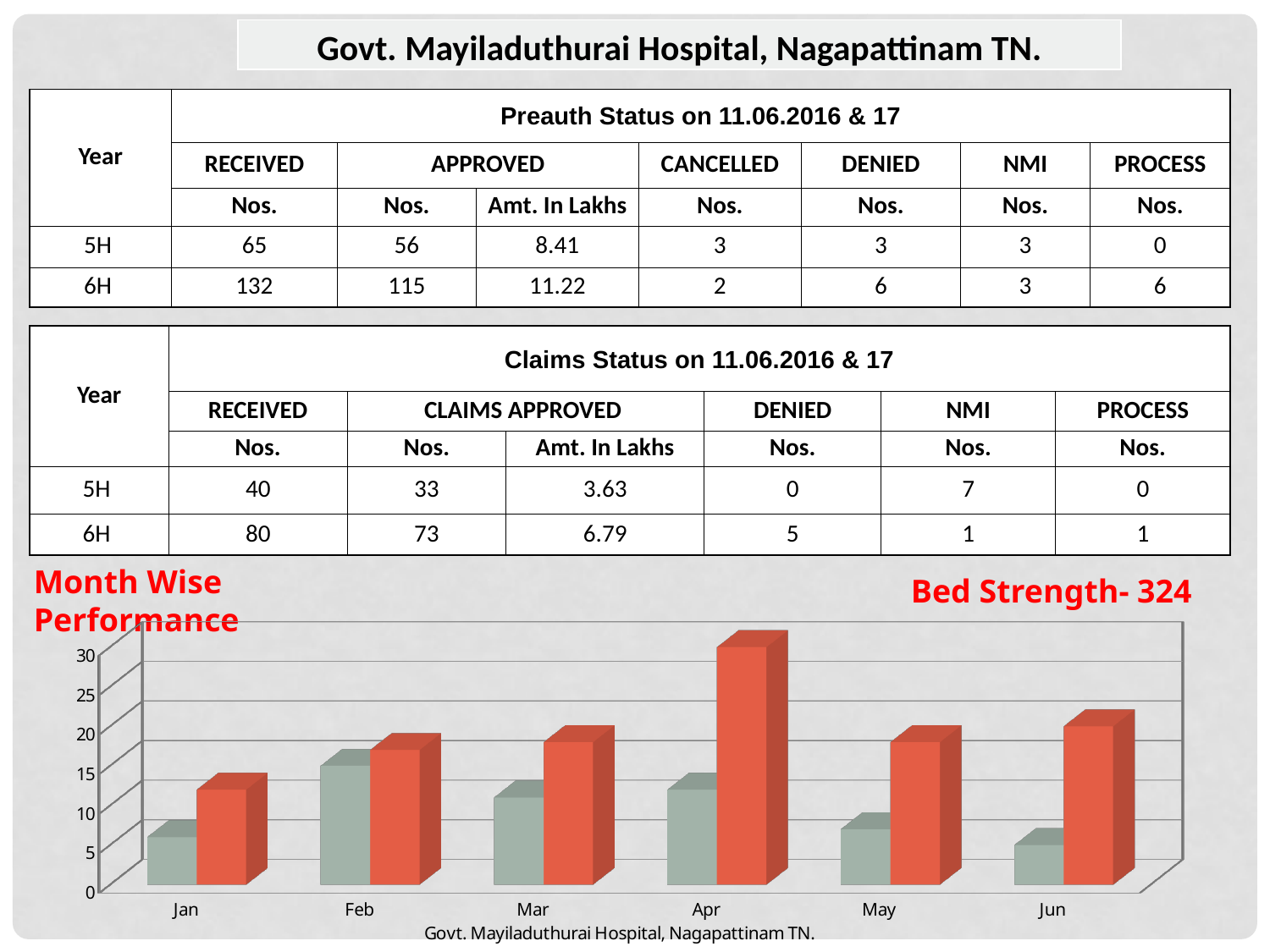
Is the red bar for Jun in the Month Wise Performance chart greater or less than 15? greater What kind of chart is shown at the bottom of the slide? bar chart In the Month Wise Performance chart, is the red bar larger for Apr or for Feb? Apr What text appears below the x axis of the Month Wise Performance chart? Govt. Mayiladuthurai Hospital, Nagapattinam TN. Is the grey bar for Jan in the Month Wise Performance chart greater or less than 10? less In the Month Wise Performance chart, which month has the tallest red bar? Apr In the Month Wise Performance chart, which month has the shortest red bar? Jan Is the grey bar for Feb in the Month Wise Performance chart greater or less than 10? greater In the Month Wise Performance chart, which month has the tallest grey bar? Feb In the Month Wise Performance chart, is the grey bar larger for Jan or for Feb? Feb How many months are shown on the x axis of the Month Wise Performance chart? 6